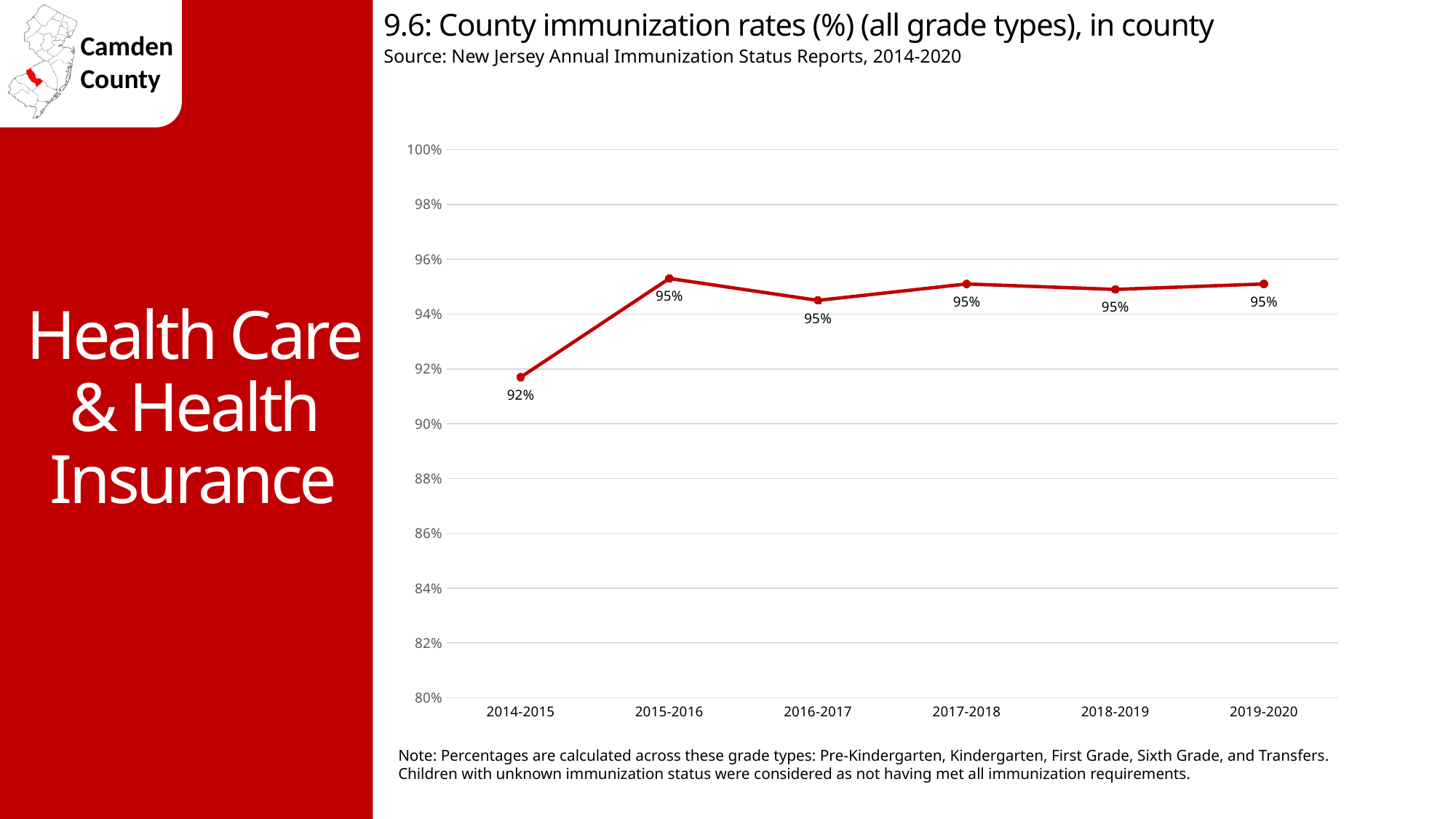
How many school years are plotted on the chart? 6 What is the source cited for the chart? New Jersey Annual Immunization Status Reports, 2014-2020 Which has a higher immunization rate, 2014-2015 or 2017-2018? 2017-2018 How does the immunization rate change from 2014-2015 to 2015-2016? It rises What is the difference in immunization rate between 2015-2016 and 2014-2015? 3 percentage points Is the immunization rate for 2016-2017 greater or less than 96%? less Is the immunization rate for 2014-2015 greater or less than 90%? greater What kind of chart is shown on the slide? line chart Which school year has the lowest county immunization rate? 2014-2015 What is the county immunization rate for 2015-2016? 95% What is the county immunization rate for 2019-2020? 95% What is the county immunization rate for 2014-2015? 92%